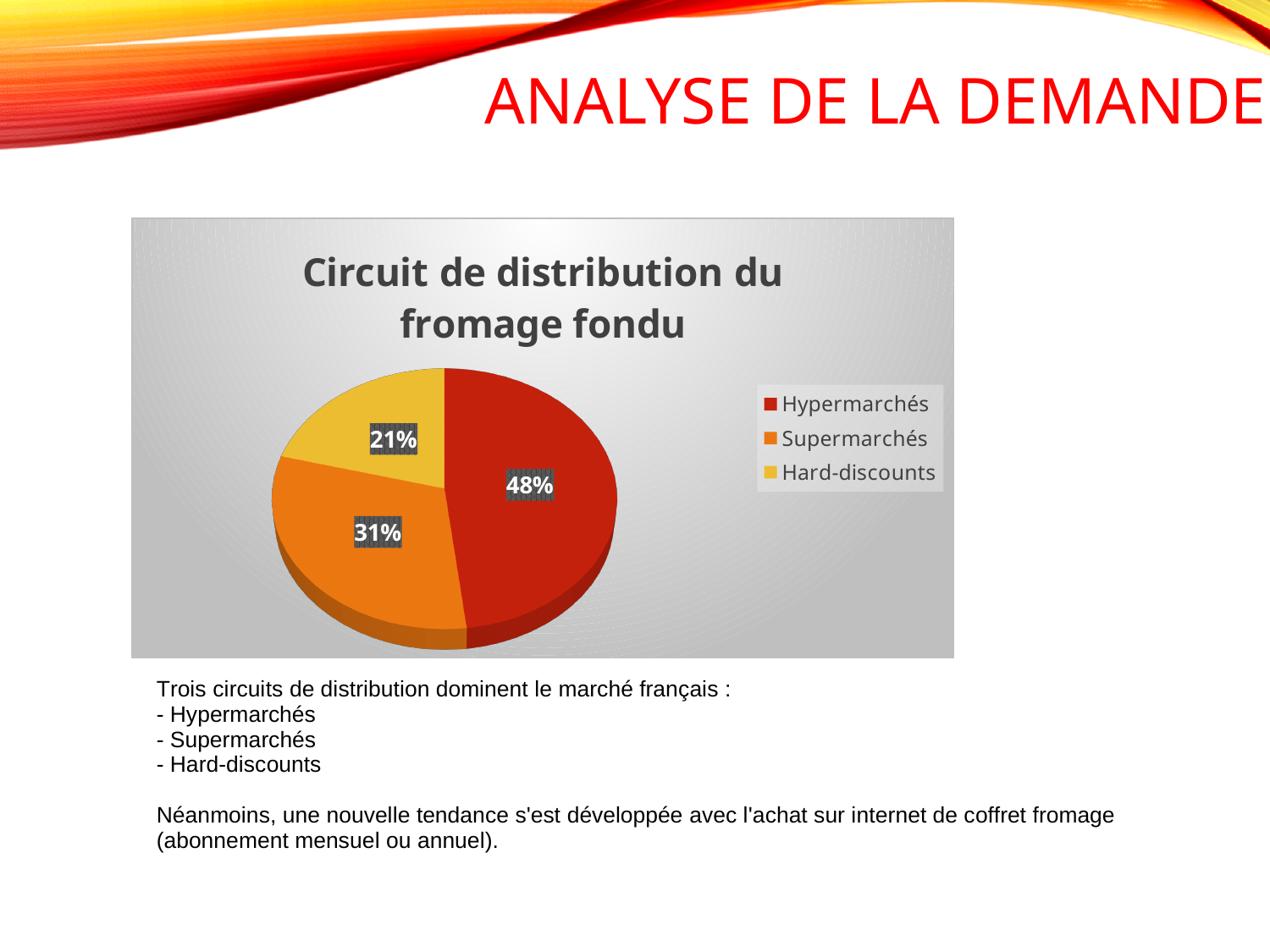
What share of the pie does Supermarchés hold? 31% What is the difference in percentage points between Supermarchés and Hard-discounts? 10 What is the difference in percentage points between Hypermarchés and Supermarchés? 17 Which distribution channel has the largest share? Hypermarchés What share of the pie does Hard-discounts hold? 21% Which has a larger share, Supermarchés or Hard-discounts? Supermarchés What share of the pie does Hypermarchés hold? 48% What kind of chart is shown on the slide? Pie chart Which colour represents Hard-discounts in the chart? Yellow What is the title of the chart? Circuit de distribution du fromage fondu Which distribution channel has the smallest share? Hard-discounts How many slices does the pie chart have? 3